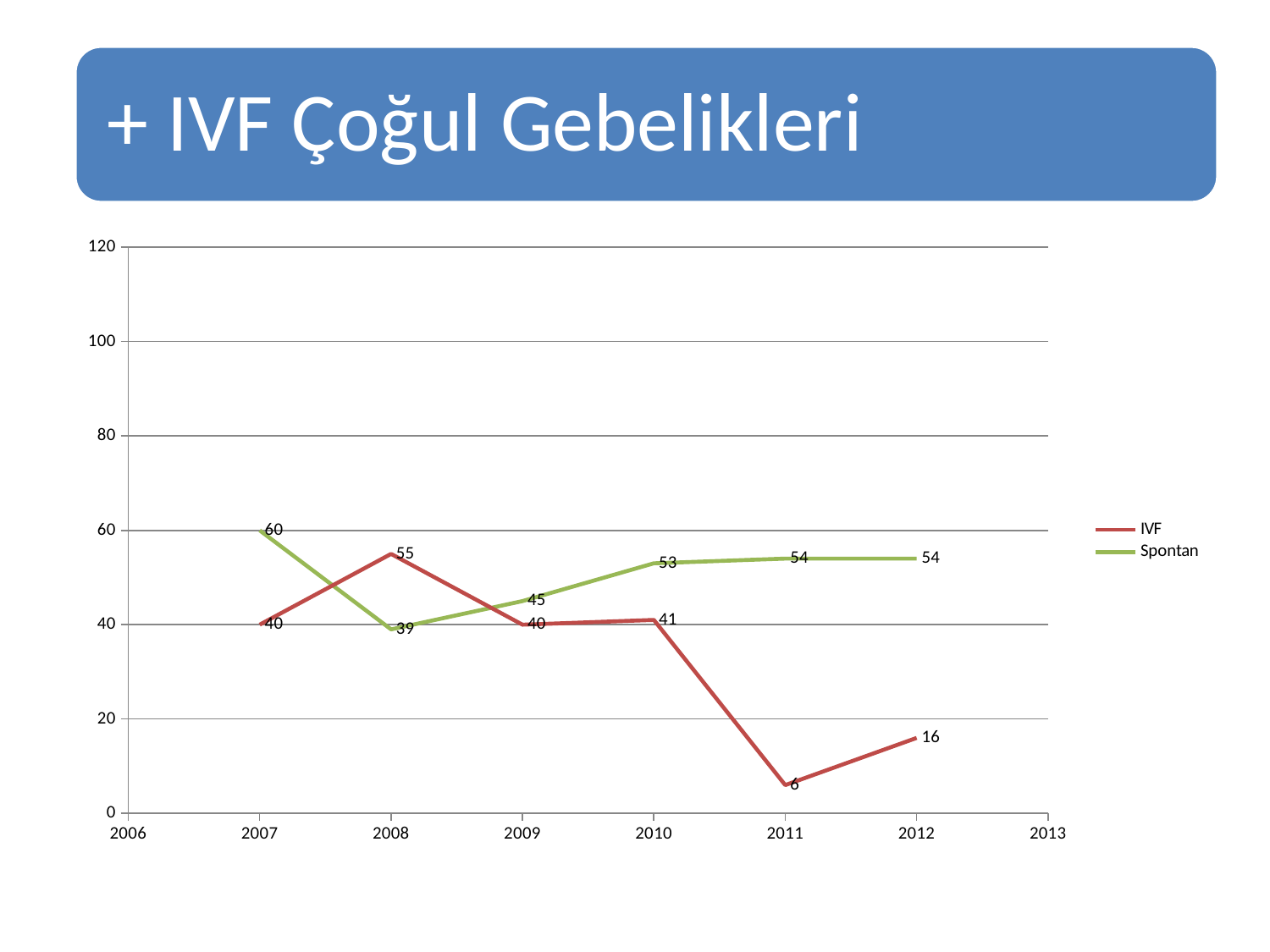
What is the Spontan value for 2012? 54 What colour is the Spontan line? Green Which series has the larger value in 2008, IVF or Spontan? IVF What is the difference between the Spontan and IVF values in 2012? 38 What is the IVF value for 2011? 6 In which year is the IVF value lowest? 2011 What is the Spontan value for 2007? 60 How many series does the legend list? 2 What type of chart is shown on the slide? Line chart In which year is the Spontan value highest? 2007 How many data points are plotted for the IVF series? 6 What is the IVF value for 2008? 55